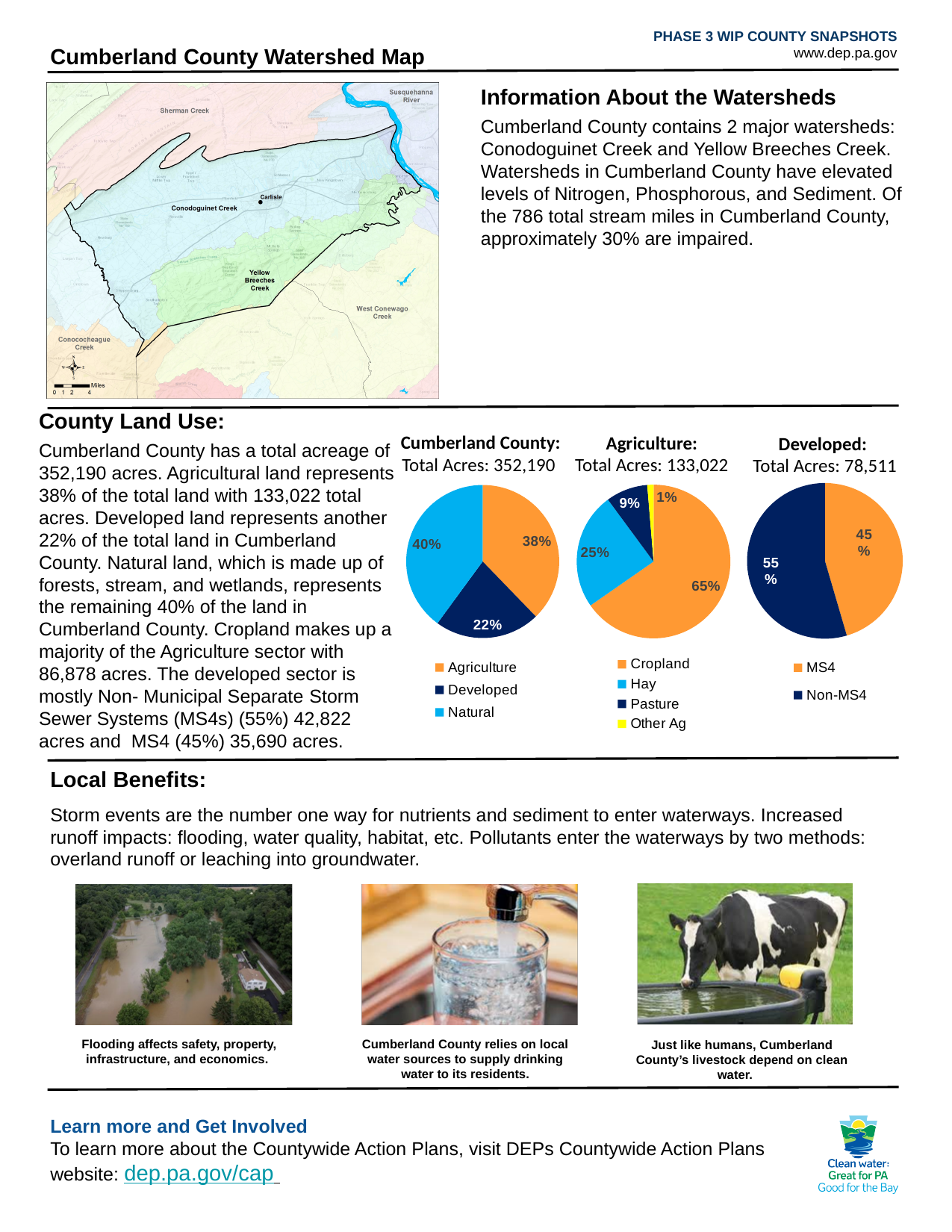
In the Agriculture pie chart, what is the difference in percentage points between Cropland and Hay? 40 In the Agriculture pie chart, what share is Hay? 25% What type of chart is used for the Developed land breakdown? Pie chart How many categories does the legend of the Agriculture pie chart list? 4 In the Developed pie chart, what share is Non-MS4? 55% In the Cumberland County pie chart, what share of land is Developed? 22% In the Cumberland County pie chart, which category has the largest share? Natural In the Developed pie chart, which is larger, MS4 or Non-MS4? Non-MS4 In the Agriculture pie chart, what share is Cropland? 65% In the Cumberland County pie chart, what share of land is Natural? 40% In the Agriculture pie chart, which category has the smallest share? Other Ag In the Cumberland County pie chart, which category has the smallest share? Developed